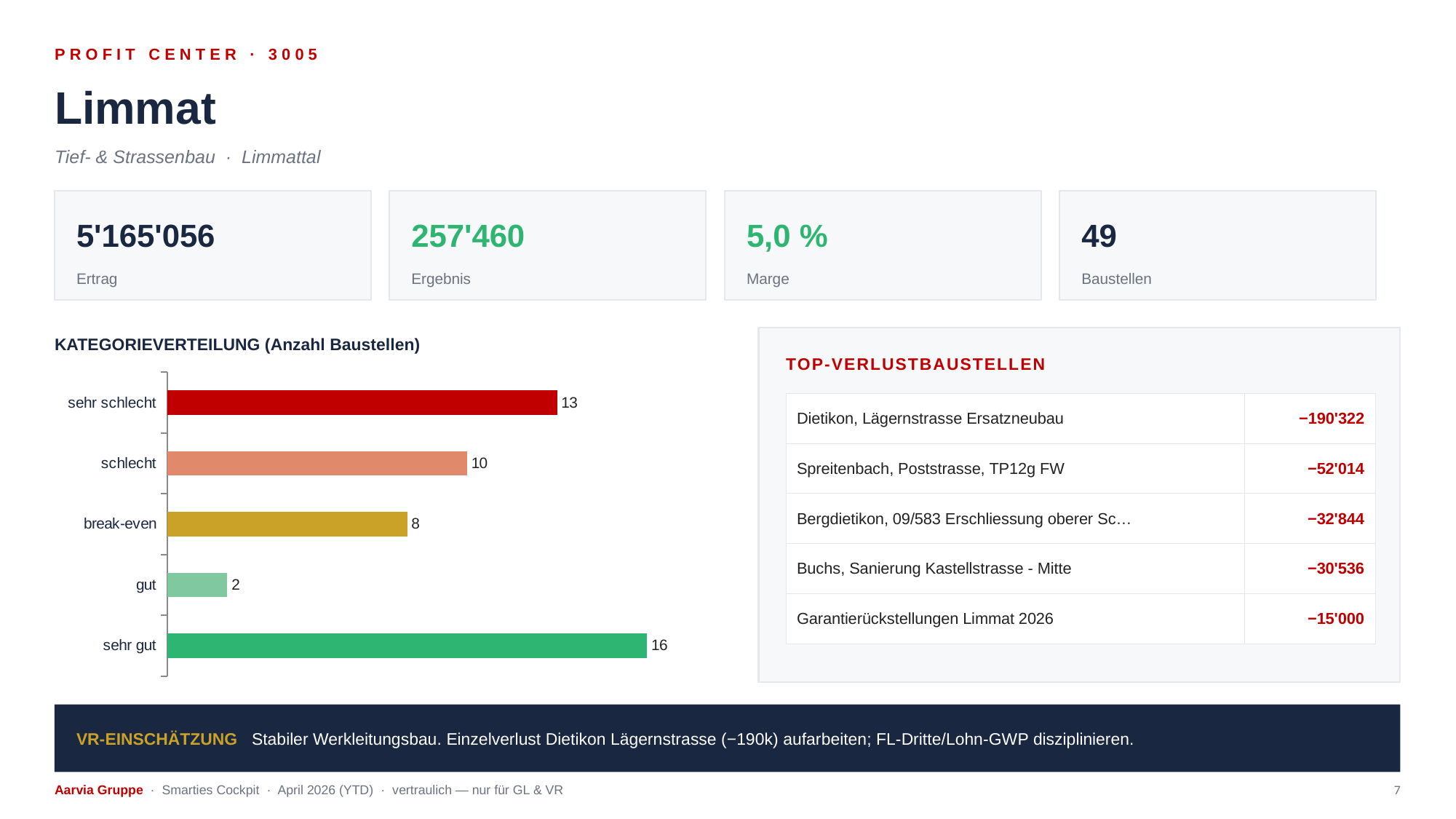
In the KATEGORIEVERTEILUNG chart, what is the value for 'break-even'? 8 In the KATEGORIEVERTEILUNG chart, what is the difference between 'sehr gut' and 'sehr schlecht'? 3 In the KATEGORIEVERTEILUNG chart, which category has the lowest number of Baustellen? gut What colour is the 'sehr schlecht' bar in the KATEGORIEVERTEILUNG chart? red In the KATEGORIEVERTEILUNG chart, what is the difference between 'schlecht' and 'break-even'? 2 In the KATEGORIEVERTEILUNG chart, which category has the highest number of Baustellen? sehr gut How many categories are shown in the KATEGORIEVERTEILUNG chart? 5 In the KATEGORIEVERTEILUNG chart, which is larger: 'schlecht' or 'break-even'? schlecht What is the total number of Baustellen across all categories in the KATEGORIEVERTEILUNG chart? 49 What type of chart is the KATEGORIEVERTEILUNG chart? bar chart In the KATEGORIEVERTEILUNG chart, what is the value for 'gut'? 2 In the KATEGORIEVERTEILUNG chart, how many Baustellen are in the 'sehr schlecht' category? 13